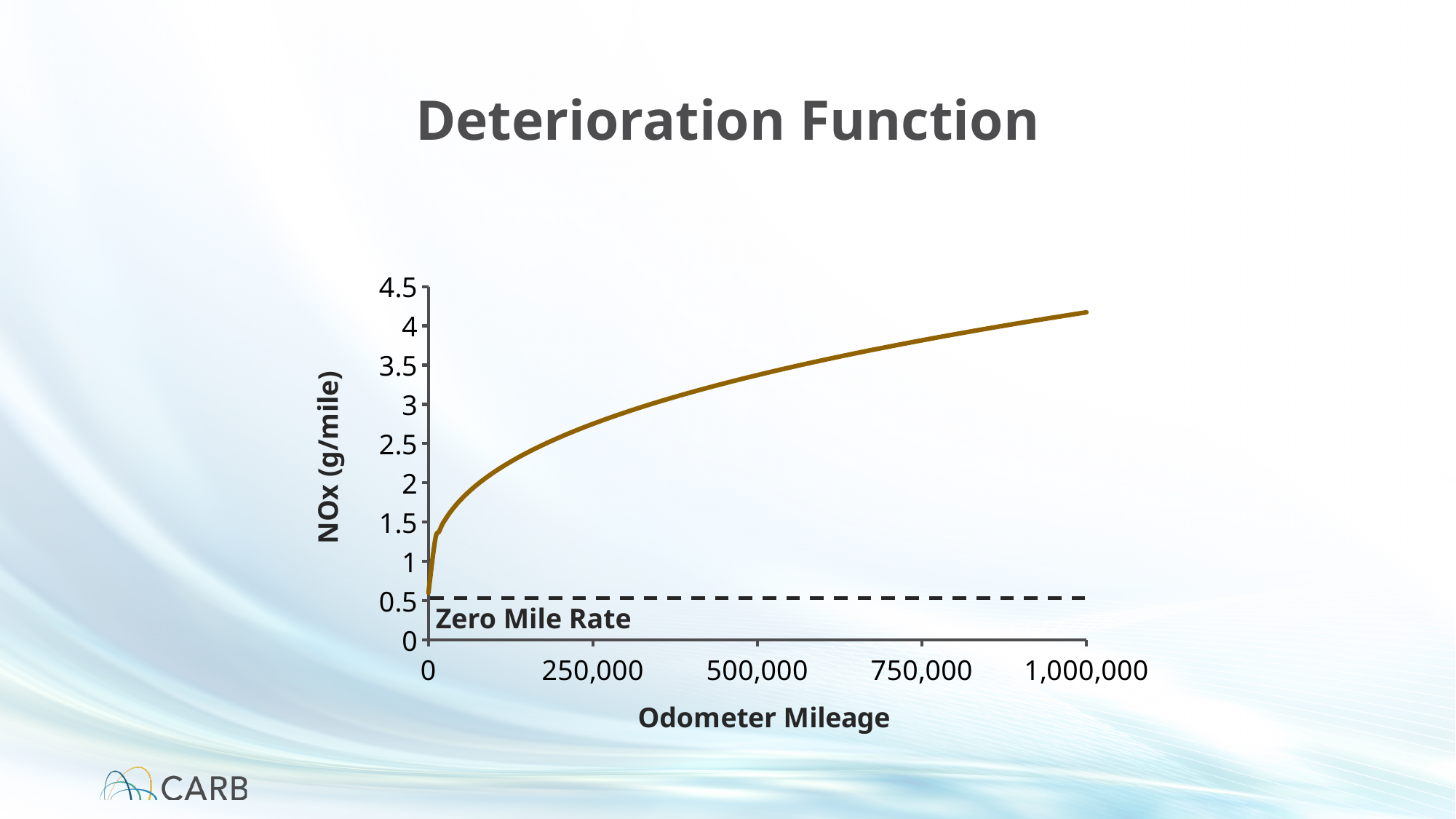
Is the NOx value at 750,000 miles greater or less than 3.5? greater How many lines are plotted on the chart (excluding the dashed reference line)? 1 Does the NOx value rise or fall as odometer mileage increases? rise Is the NOx value at 250,000 miles greater or less than 3? less Is the NOx value at 1,000,000 miles greater or less than 4? greater What is the title of the chart? Deterioration Function What kind of chart is shown on the slide? line chart What is the label of the y axis? NOx (g/mile) What is the largest odometer mileage labelled on the x axis? 1,000,000 What is the highest value shown on the y axis? 4.5